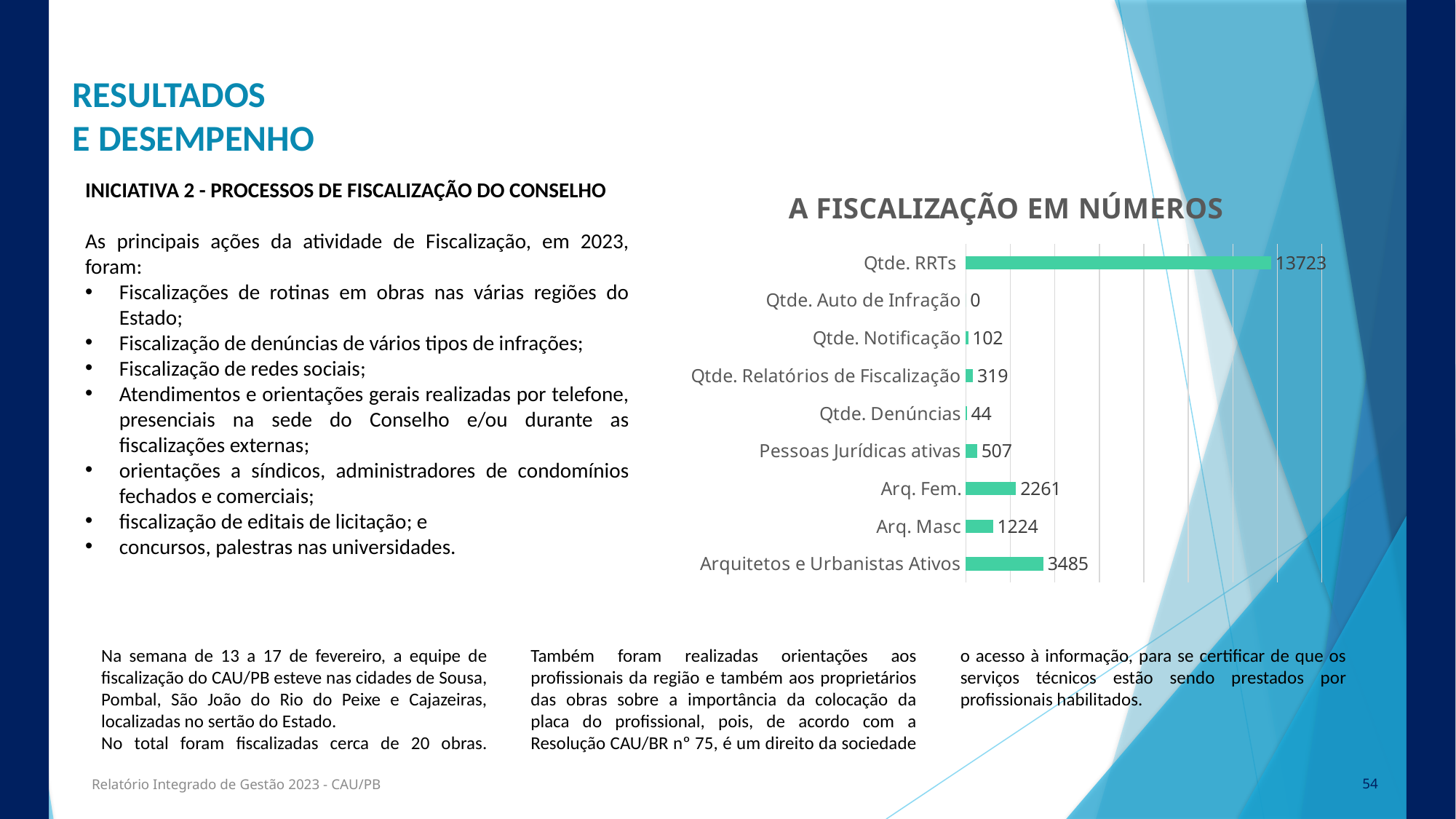
Which is larger, Qtde. Relatórios de Fiscalização or Qtde. Denúncias? Qtde. Relatórios de Fiscalização What is the difference between Arq. Fem. and Arq. Masc? 1037 How many categories are shown in the chart? 9 What is the value for Qtde. RRTs? 13723 What is the difference between Qtde. RRTs and Arquitetos e Urbanistas Ativos? 10238 What is the value for Pessoas Jurídicas ativas? 507 What is the value for Arquitetos e Urbanistas Ativos? 3485 What is the value for Qtde. Notificação? 102 What kind of chart is shown? Bar chart Which category has the lowest value? Qtde. Auto de Infração Which category has the highest value? Qtde. RRTs What is the title of the chart? A FISCALIZAÇÃO EM NÚMEROS